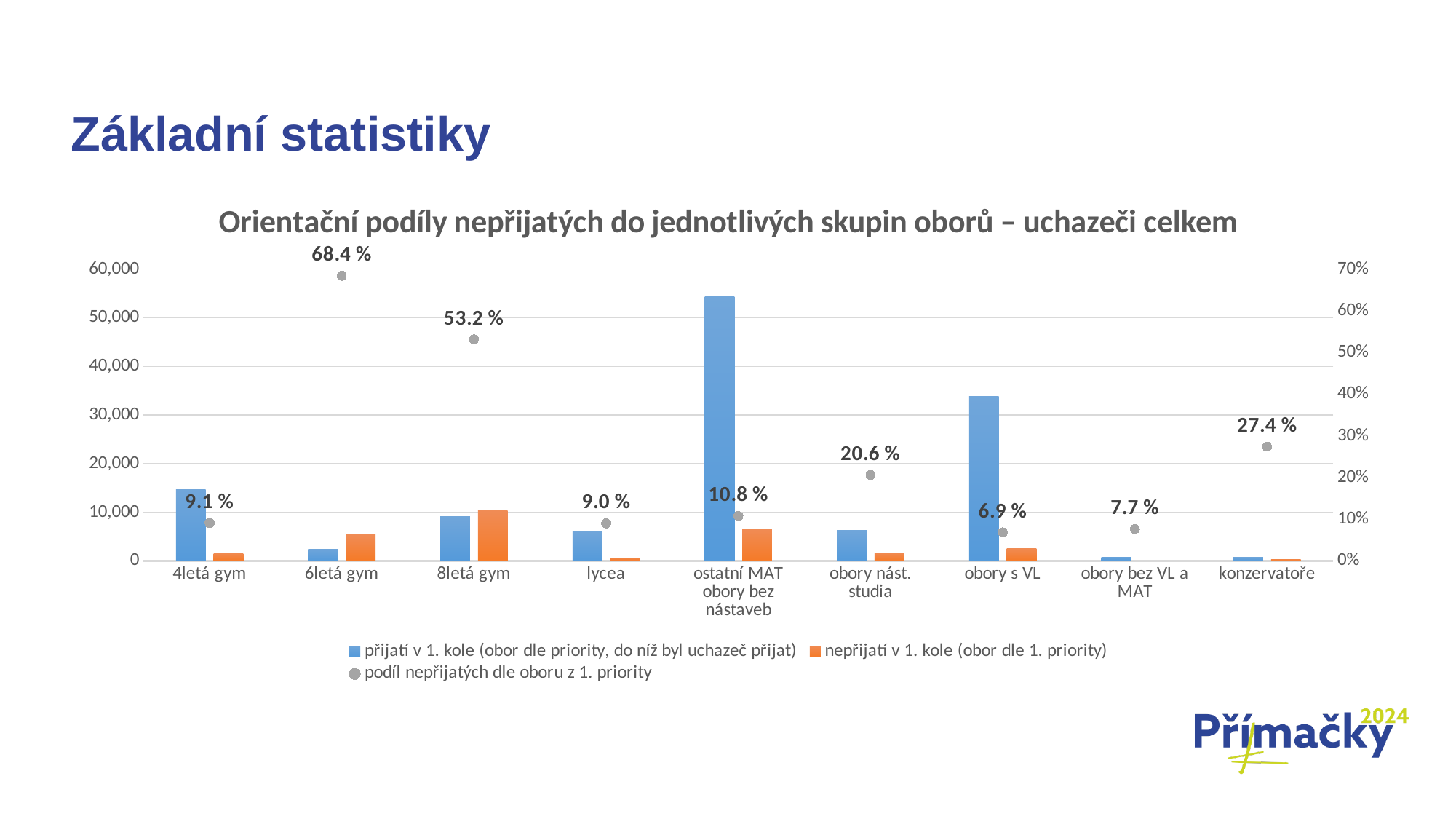
What is the difference in 'podíl nepřijatých dle oboru z 1. priority' between 6letá gym and 8letá gym? 15.2 percentage points What is the value of 'podíl nepřijatých dle oboru z 1. priority' for konzervatoře? 27.4 % How many categories are shown on the x axis? 9 Which category has the lowest 'podíl nepřijatých dle oboru z 1. priority'? obory s VL Which category has the highest 'podíl nepřijatých dle oboru z 1. priority'? 6letá gym Which has a higher 'podíl nepřijatých dle oboru z 1. priority': 8letá gym or konzervatoře? 8letá gym Is the value of 'přijatí v 1. kole' for ostatní MAT obory bez nástaveb greater or less than 50,000? greater What is the title of the chart? Orientační podíly nepřijatých do jednotlivých skupin oborů – uchazeči celkem What is the value of 'podíl nepřijatých dle oboru z 1. priority' for 6letá gym? 68.4 % Is the value of 'nepřijatí v 1. kole' for 6letá gym greater or less than 10,000? less How many series does the legend list? 3 What is the value of 'podíl nepřijatých dle oboru z 1. priority' for obory nást. studia? 20.6 %